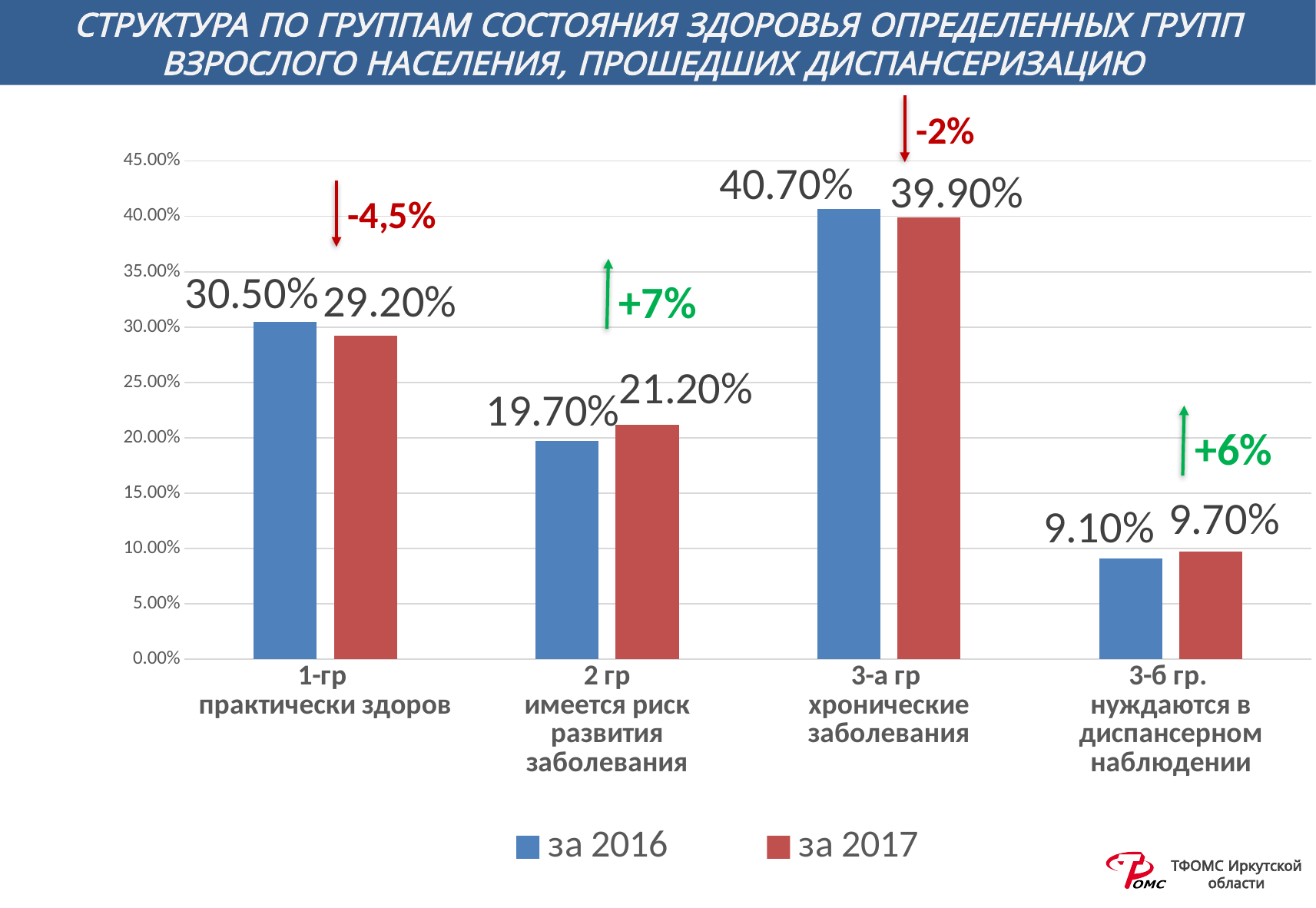
What is the value for "2 гр имеется риск развития заболевания" in the "за 2017" series? 21.20% How many series does the legend list? 2 What colour are the bars for the "за 2017" series? Red Which category has the lowest value in the "за 2017" series? 3-б гр. нуждаются в диспансерном наблюдении What kind of chart is shown on the slide? Bar chart What is the value for "3-б гр. нуждаются в диспансерном наблюдении" in the "за 2016" series? 9.10% How many categories are shown on the x axis? 4 For "2 гр имеется риск развития заболевания", which series has the larger value, "за 2016" or "за 2017"? за 2017 What is the value for "3-а гр хронические заболевания" in the "за 2017" series? 39.90% Which category has the highest value in the "за 2016" series? 3-а гр хронические заболевания What is the value for "1-гр практически здоров" in the "за 2016" series? 30.50% What is the difference between the "за 2016" and "за 2017" values for "1-гр практически здоров"? 1.30%